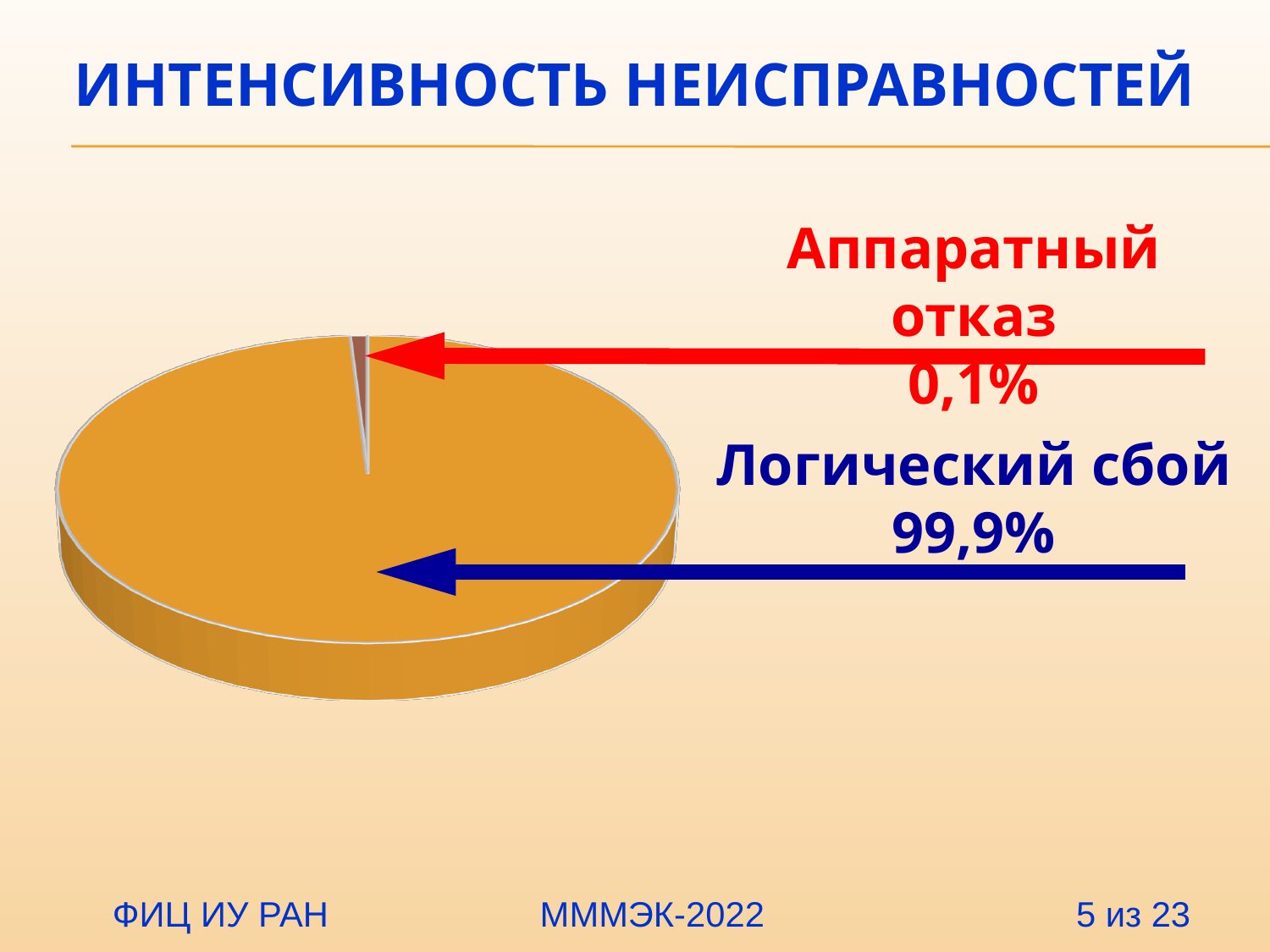
How many slices does the pie chart have? 2 What colour is the arrow pointing to the "Аппаратный отказ" slice? red What is the title of the slide containing the pie chart? ИНТЕНСИВНОСТЬ НЕИСПРАВНОСТЕЙ Which slice of the pie is the largest? Логический сбой Which is larger, the share for "Логический сбой" or the share for "Аппаратный отказ"? Логический сбой Which slice of the pie is the smallest? Аппаратный отказ What is the difference in percentage points between the "Логический сбой" share and the "Аппаратный отказ" share? 99,8 What kind of chart is shown on the slide? pie chart What share of the pie does "Логический сбой" represent? 99,9% What share of the pie does "Аппаратный отказ" represent? 0,1%